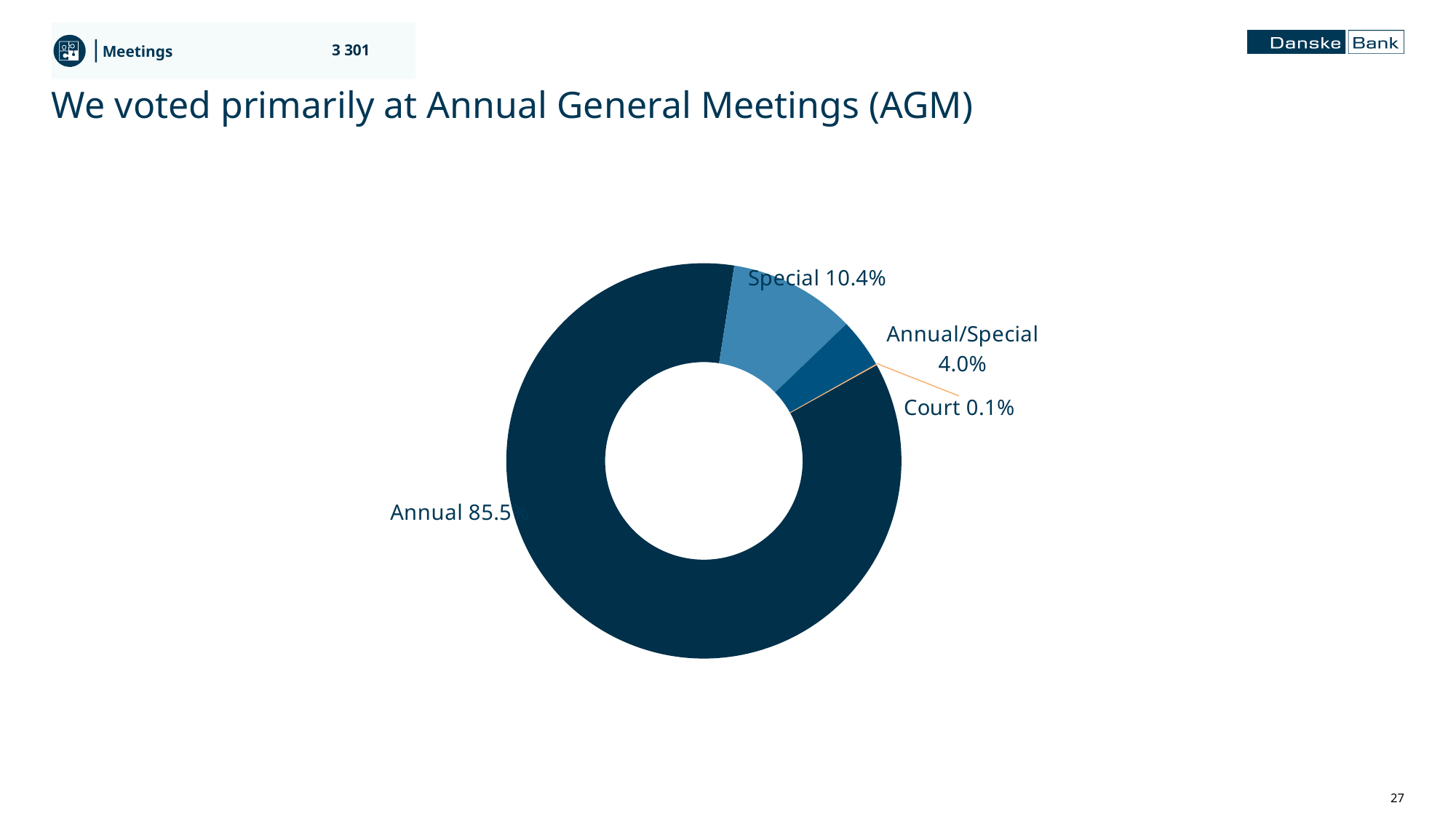
What is the difference in percentage points between the Annual and Special shares? 75.1 What is the title of the slide? We voted primarily at Annual General Meetings (AGM) What share of meetings were Special meetings? 10.4% What share of meetings were Annual meetings? 85.5% How many meeting types are shown in the chart? 4 What share of meetings were Court meetings? 0.1% Which meeting type has the smallest share of the chart? Court What share of meetings were Annual/Special meetings? 4.0% What kind of chart is shown on the slide? Doughnut (pie) chart Which meeting type has the largest share of the chart? Annual What is the difference in percentage points between the Special and Annual/Special shares? 6.4 Which has a larger share, Special or Annual/Special? Special